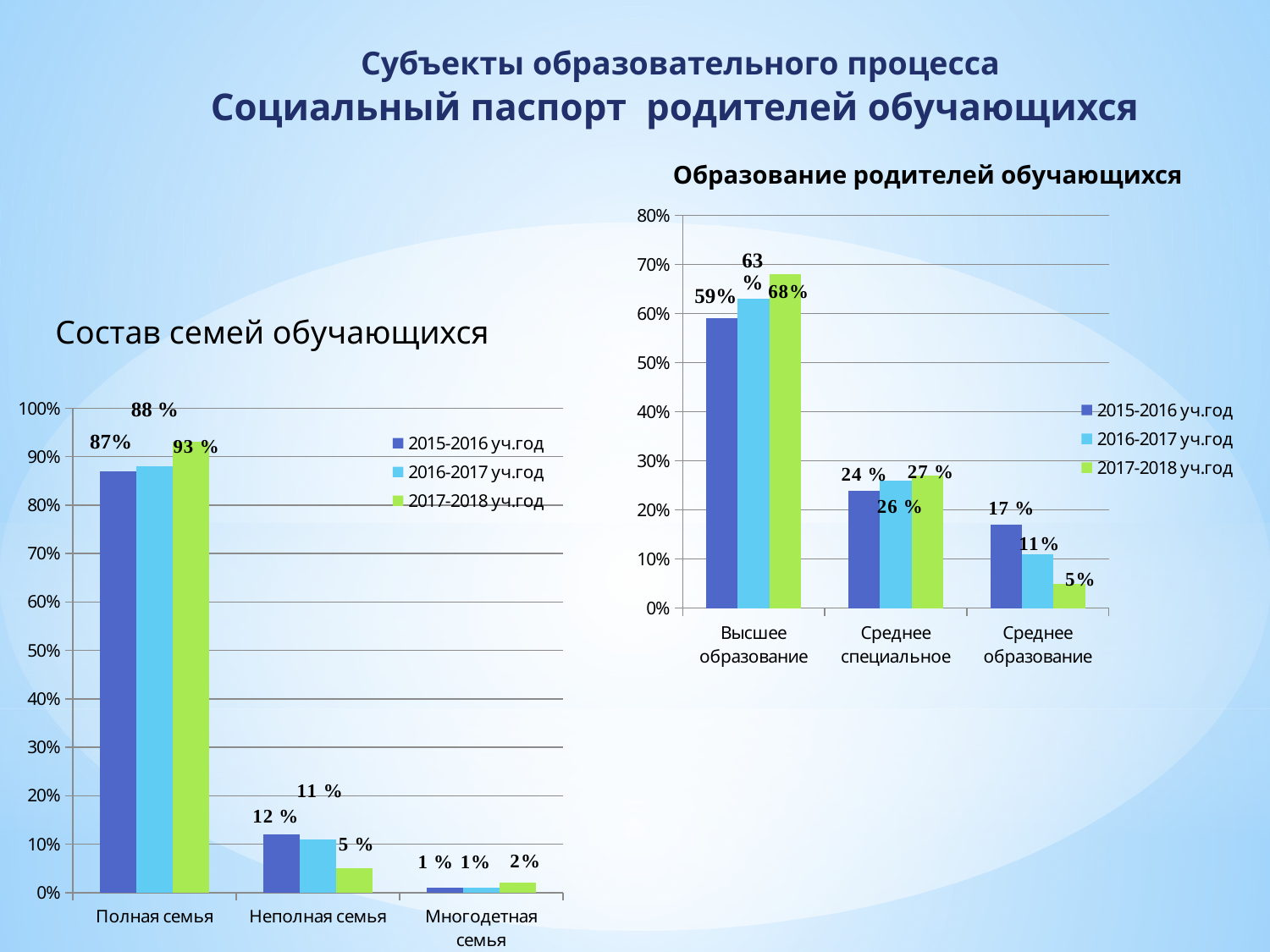
In the chart 'Образование родителей обучающихся', do the values for Среднее образование rise or fall from 2015-2016 уч.год to 2017-2018 уч.год? fall In the chart 'Образование родителей обучающихся', what is the value for Высшее образование in 2016-2017 уч.год? 63 % In the chart 'Образование родителей обучающихся', which is larger for Среднее специальное: the 2015-2016 уч.год value or the 2017-2018 уч.год value? 2017-2018 уч.год What kind of chart is 'Состав семей обучающихся'? bar chart In the chart 'Состав семей обучающихся', what is the value for Неполная семья in 2015-2016 уч.год? 12 % In the chart 'Состав семей обучающихся', how many categories are shown on the x axis? 3 In the chart 'Состав семей обучающихся', what is the difference between the 2017-2018 уч.год and 2015-2016 уч.год values for Полная семья? 6 % In the chart 'Состав семей обучающихся', what is the value for Полная семья in 2017-2018 уч.год? 93 % In the chart 'Образование родителей обучающихся', what is the value for Среднее образование in 2017-2018 уч.год? 5% How many series does the legend of the chart 'Образование родителей обучающихся' list? 3 In the chart 'Образование родителей обучающихся', which category has the highest value in 2017-2018 уч.год? Высшее образование In the chart 'Состав семей обучающихся', what is the value for Многодетная семья in 2017-2018 уч.год? 2%